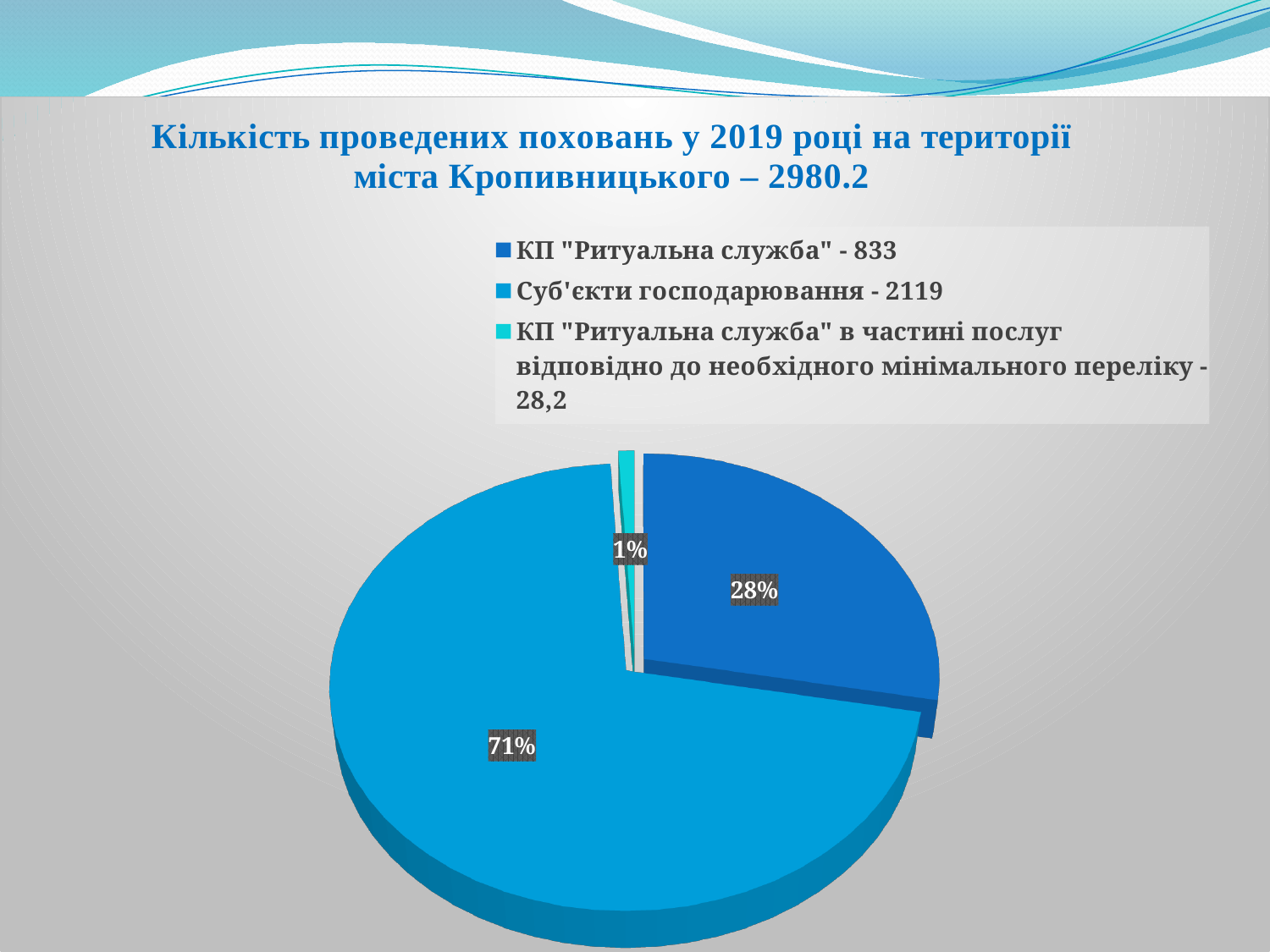
What percentage share of the pie is labelled for КП "Ритуальна служба" в частині послуг відповідно до необхідного мінімального переліку? 1% How many slices does the pie chart have? 3 What kind of chart is shown on the slide? pie chart Which slice is larger: КП "Ритуальна служба" or Суб'єкти господарювання? Суб'єкти господарювання What percentage share of the pie is labelled for КП "Ритуальна служба"? 28% What is the difference in percentage points between the 71% slice and the 28% slice? 43 percentage points Which category has the smallest slice of the pie? КП "Ритуальна служба" в частині послуг відповідно до необхідного мінімального переліку Which category has the largest slice of the pie? Суб'єкти господарювання How many entries does the legend list? 3 According to the legend, what value is given for КП "Ритуальна служба"? 833 According to the legend, what value is given for Суб'єкти господарювання? 2119 What percentage share of the pie is labelled for Суб'єкти господарювання? 71%